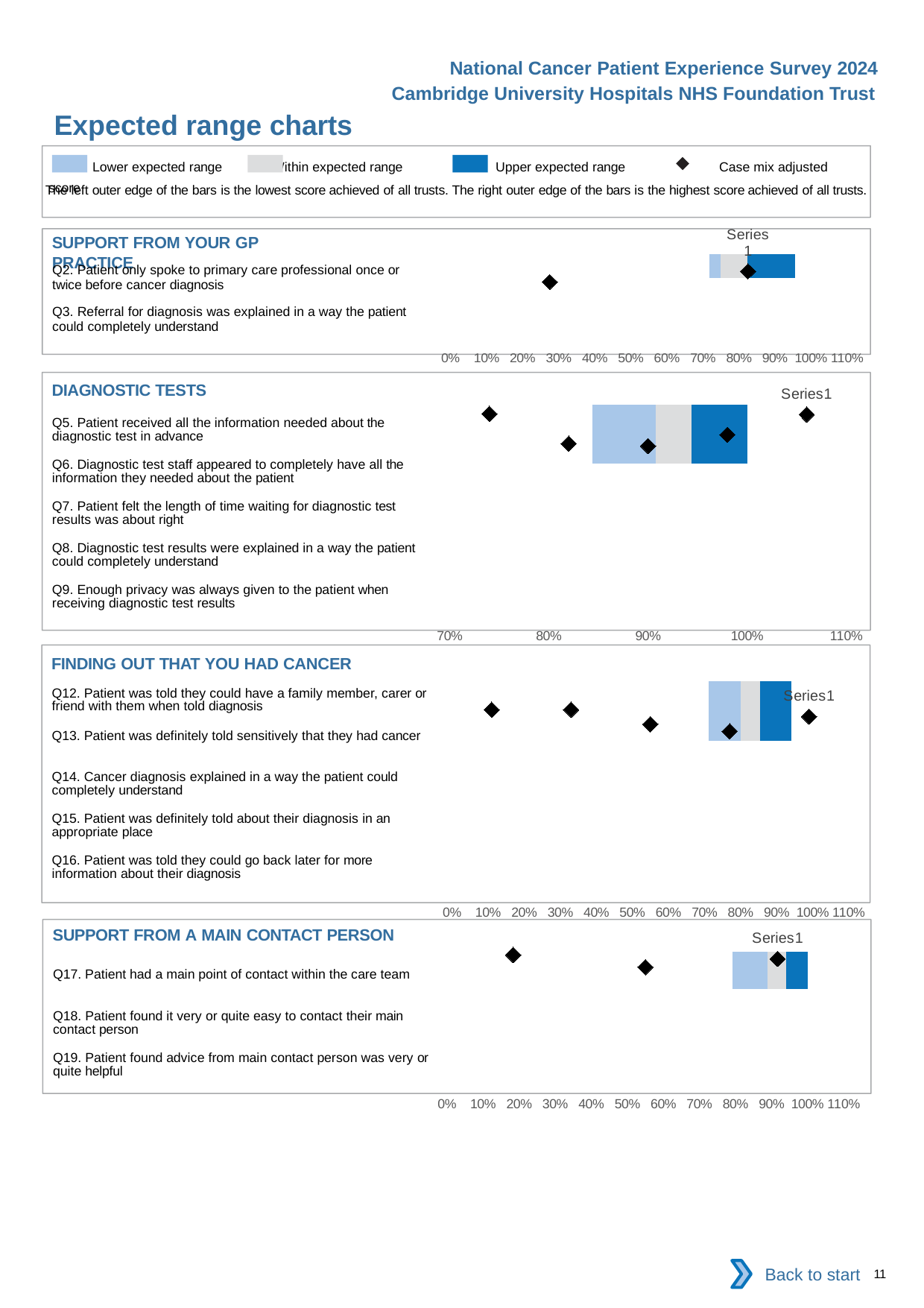
What kind of chart is used in the 'SUPPORT FROM YOUR GP PRACTICE' section? bar chart In the 'SUPPORT FROM YOUR GP PRACTICE' chart, is the leftmost diamond marker greater or less than 50%? less How many questions are listed in the 'SUPPORT FROM YOUR GP PRACTICE' chart? 2 According to the legend, what does the dark blue colour represent? Upper expected range How many questions are listed in the 'FINDING OUT THAT YOU HAD CANCER' chart? 5 How many questions are listed in the 'SUPPORT FROM A MAIN CONTACT PERSON' chart? 3 In the 'FINDING OUT THAT YOU HAD CANCER' chart, is the leftmost diamond marker greater or less than 20%? less What is the lowest value shown on the x axis of the 'DIAGNOSTIC TESTS' chart? 70% In the 'SUPPORT FROM A MAIN CONTACT PERSON' chart, is the leftmost diamond marker greater or less than 30%? less How many entries does the legend at the top of the slide list? 4